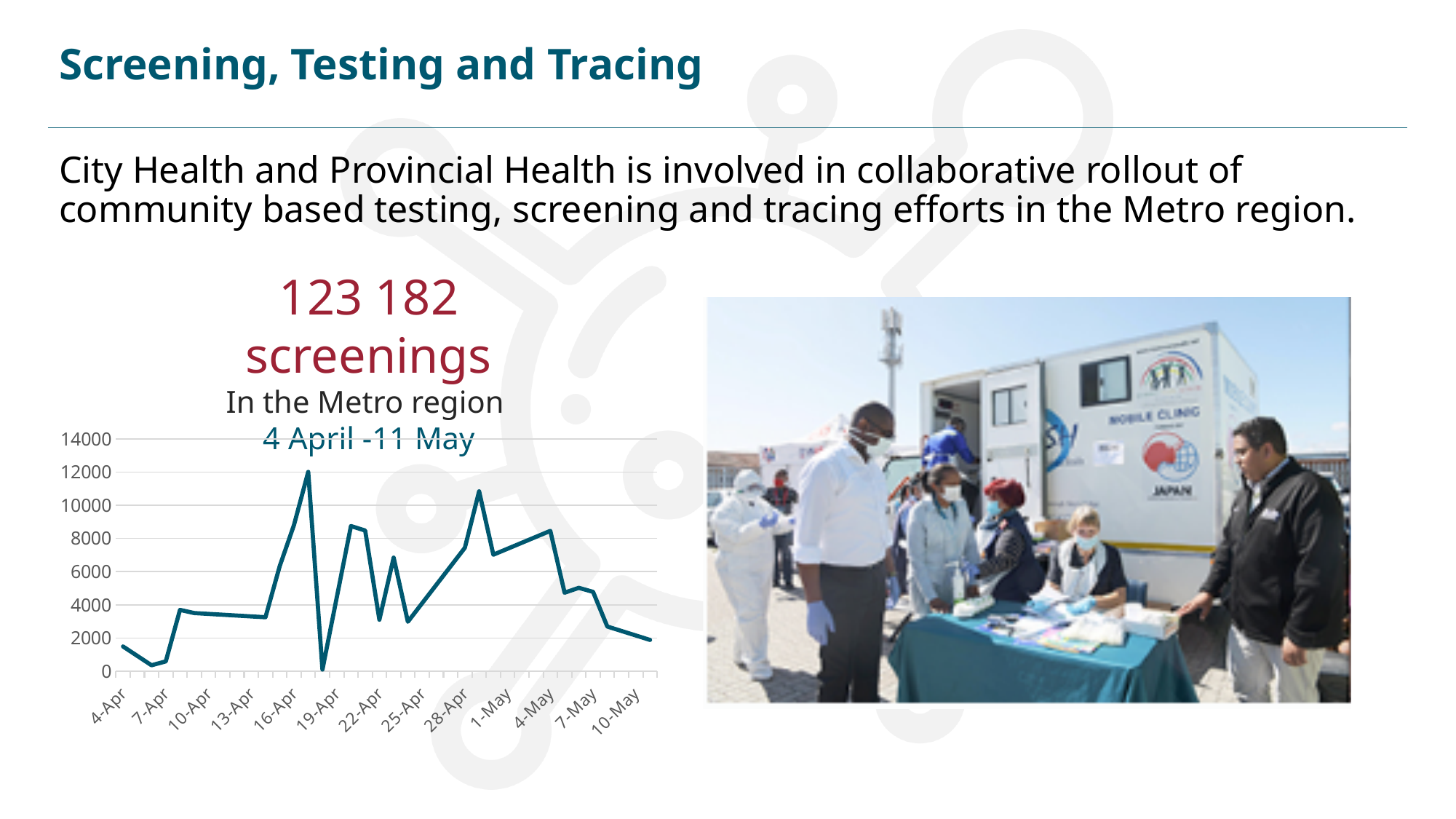
How many date labels are shown on the x axis? 13 What kind of chart is shown on the slide? line chart What total number of screenings is stated above the chart? 123 182 screenings Is the value for 7-May greater or less than 6000? less Is the value for 7-Apr greater or less than 2000? less Is the value for 28-Apr greater or less than 6000? greater Do the values rise or fall between 4-May and 10-May? fall Which date has the higher value, 16-Apr or 4-Apr? 16-Apr What date range is given for the screenings above the chart? 4 April -11 May